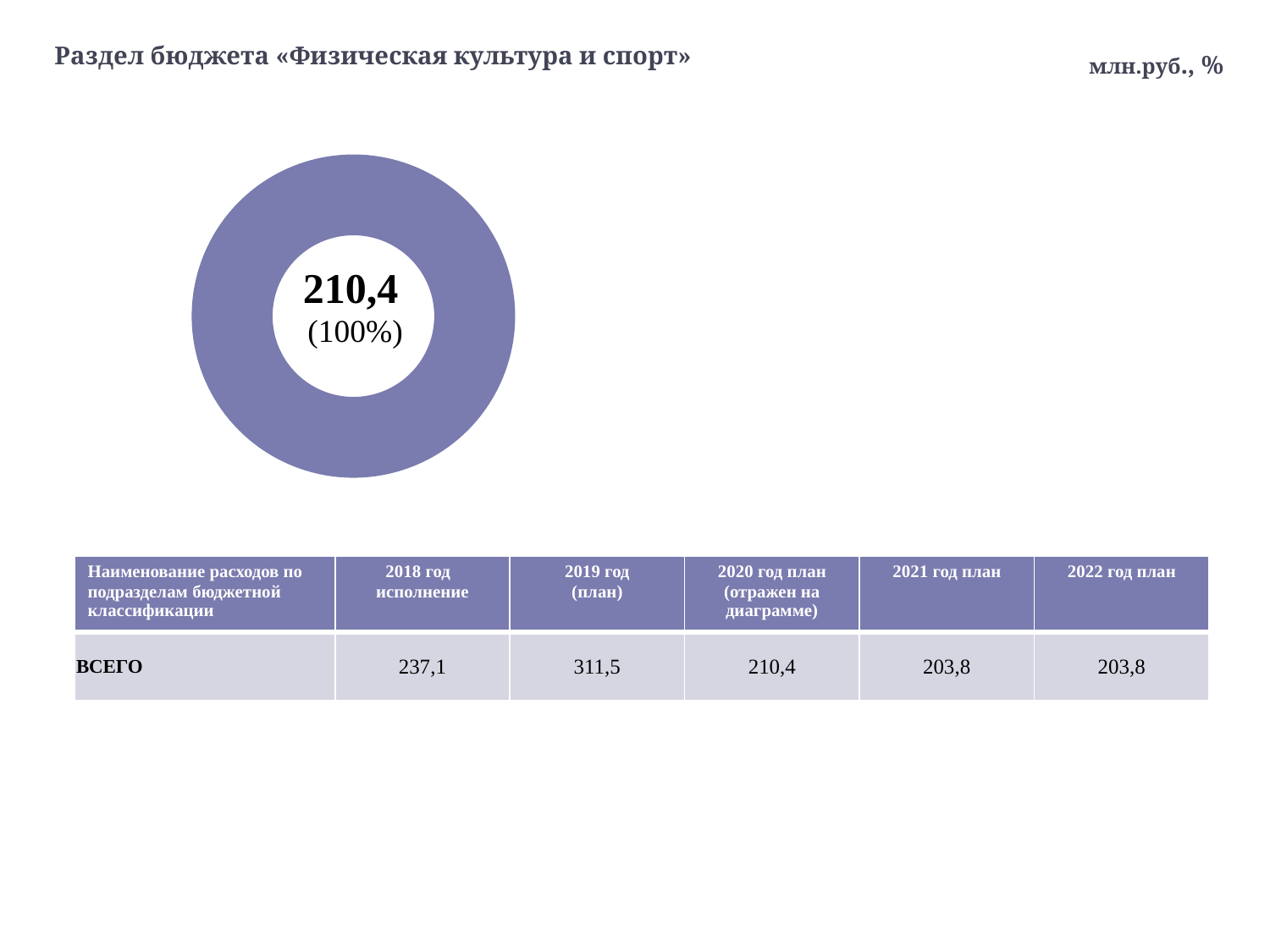
Which year's value does the donut chart reflect, according to the table header? 2020 год план What units are indicated in the top right corner of the slide for the chart values? млн.руб., % Is the value shown in the donut chart greater or less than 200? greater How many slices does the donut chart contain? 1 What value is printed in the centre of the donut chart? 210,4 What kind of chart is shown on the slide? Donut (pie) chart What share of the donut chart does the single slice represent? 100%